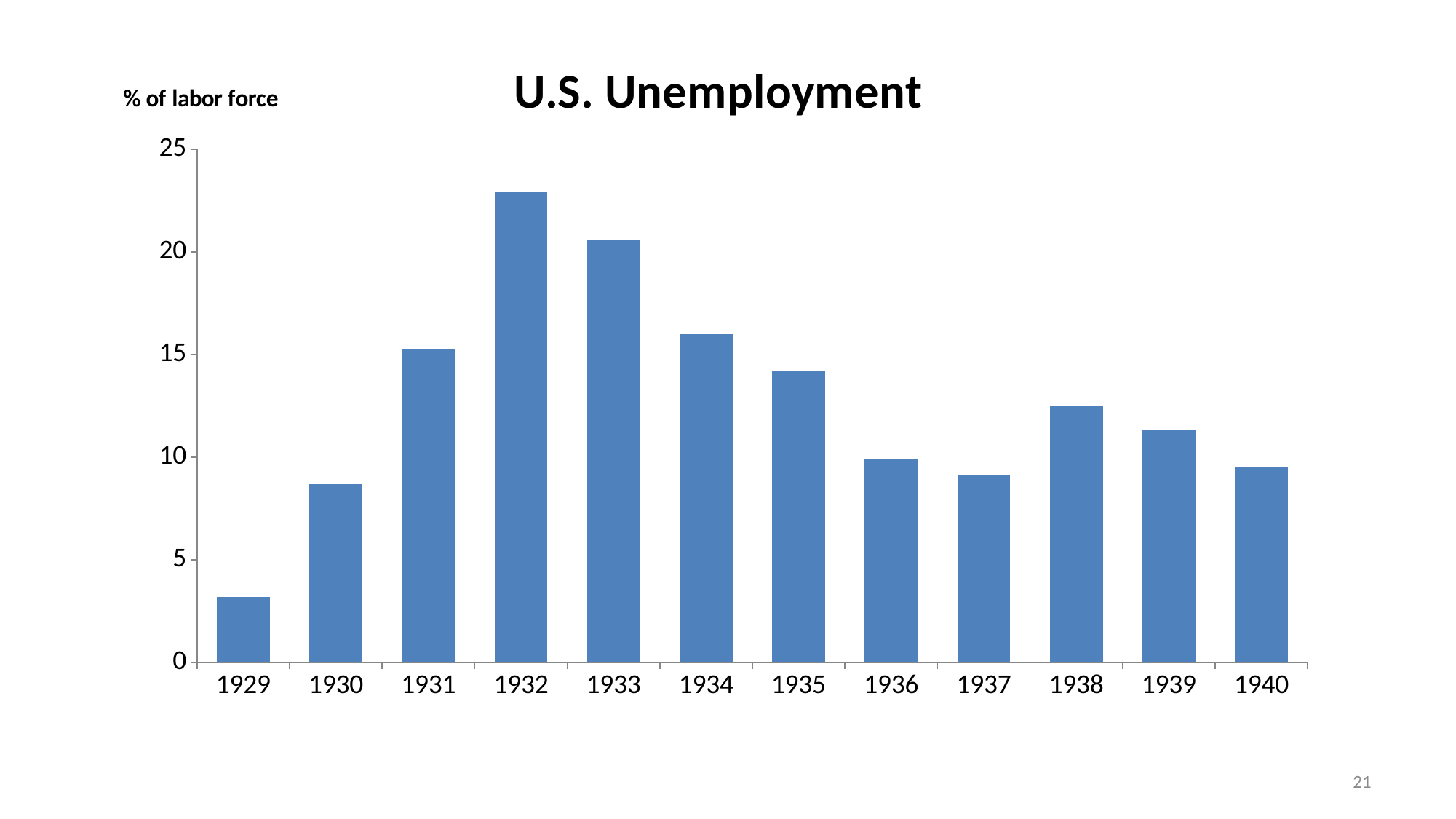
Is the value for 1938 greater or less than 10? greater Is the value for 1937 greater or less than 10? less Which year has the higher unemployment rate, 1933 or 1934? 1933 What unit label is shown above the vertical axis? % of labor force What is the title of the chart? U.S. Unemployment Is the value for 1929 greater or less than 5? less Do the values rise or fall from 1929 to 1932? rise What type of chart is shown on the slide? Bar chart Which year has the highest unemployment rate? 1932 Which year has the lowest unemployment rate? 1929 How many years are shown on the x axis? 12